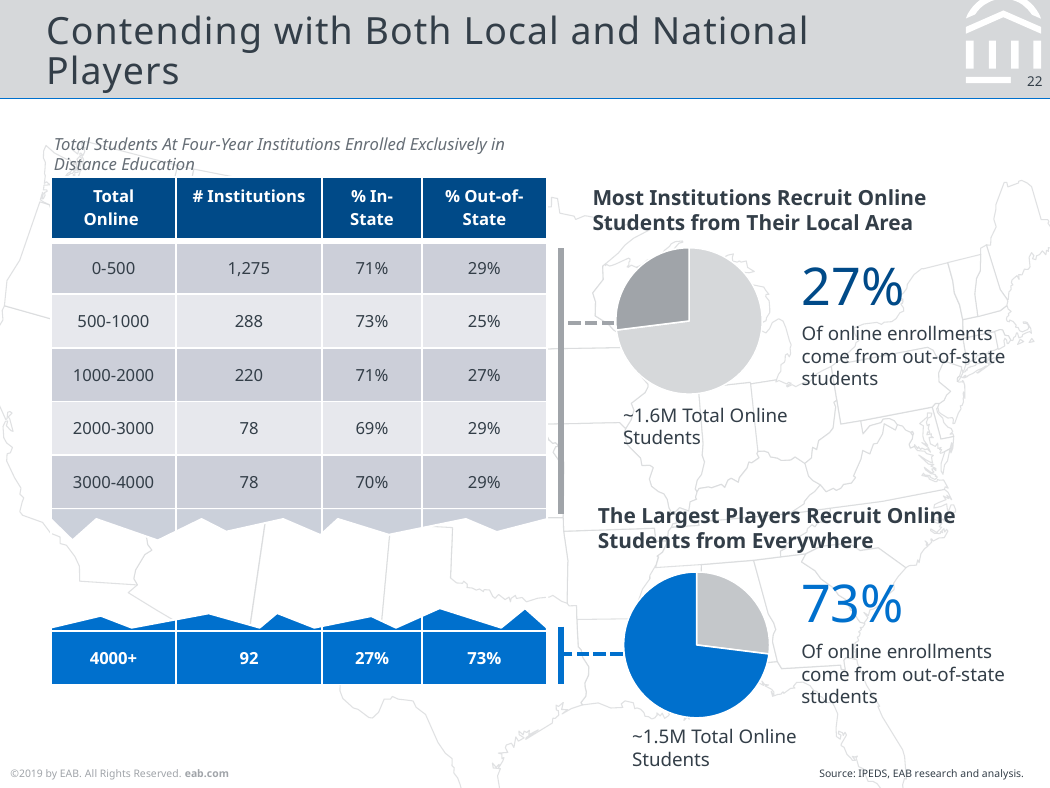
In the pie chart titled "Most Institutions Recruit Online Students from Their Local Area", what share of online enrollments come from out-of-state students? 27% What is the difference in percentage points between the out-of-state share in the bottom pie chart (73%) and the out-of-state share in the top pie chart (27%)? 46 percentage points In the bottom pie chart ("The Largest Players Recruit Online Students from Everywhere"), is the out-of-state share greater or less than 50%? greater Which pie chart shows the larger out-of-state share: the top one ("Most Institutions Recruit Online Students from Their Local Area") or the bottom one ("The Largest Players Recruit Online Students from Everywhere")? The bottom one (The Largest Players Recruit Online Students from Everywhere) In the pie chart titled "The Largest Players Recruit Online Students from Everywhere", what share of online enrollments come from out-of-state students? 73% What colour is the larger slice in the bottom pie chart ("The Largest Players Recruit Online Students from Everywhere")? Blue How many slices does the pie chart under "The Largest Players Recruit Online Students from Everywhere" have? 2 In the top pie chart ("Most Institutions Recruit Online Students from Their Local Area"), is the out-of-state share greater or less than 50%? less What kind of chart is used under the heading "Most Institutions Recruit Online Students from Their Local Area"? Pie chart What is the heading above the top pie chart on the slide? Most Institutions Recruit Online Students from Their Local Area How many pie charts are shown on the slide? 2